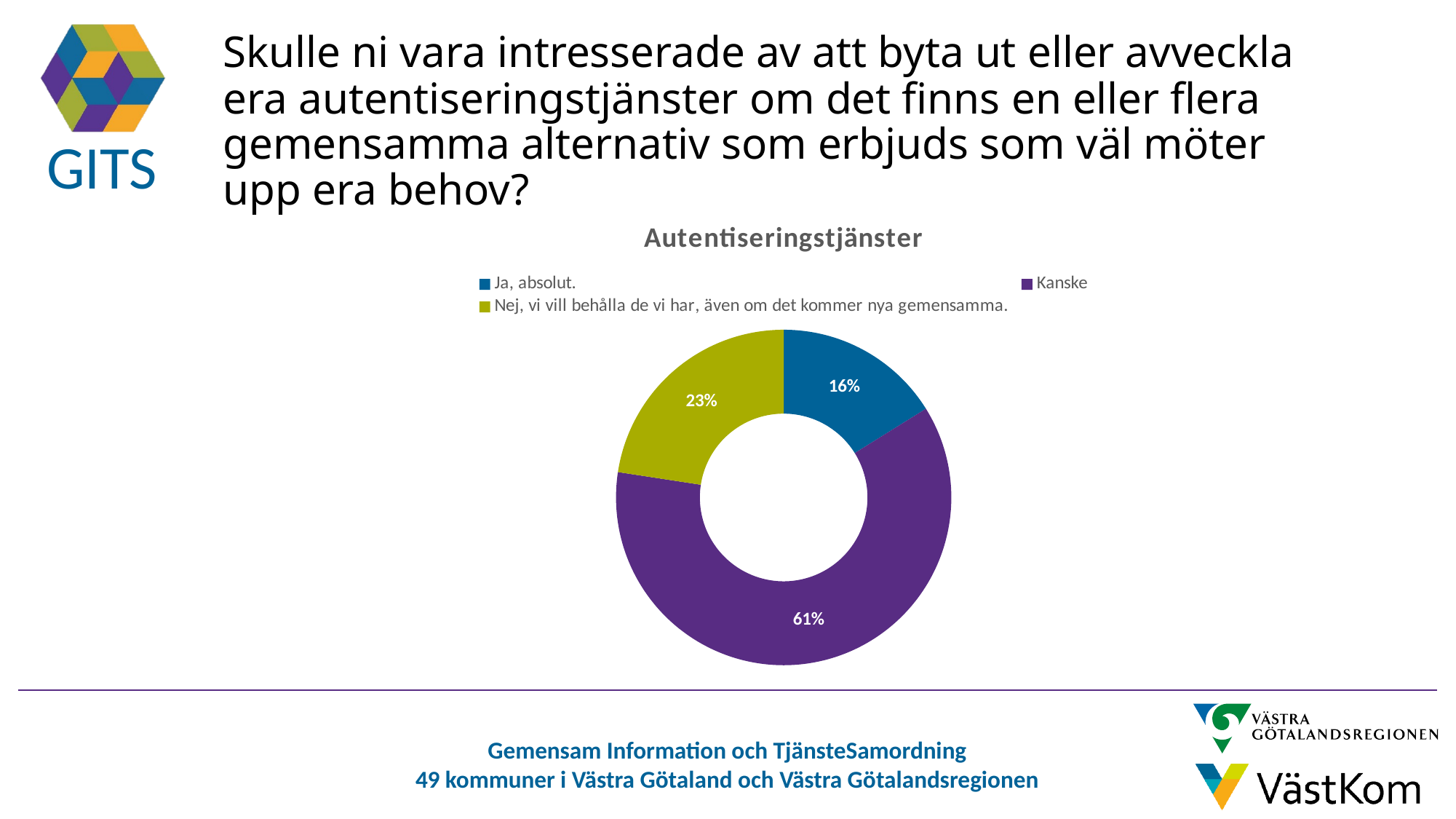
How many categories does the chart show? 3 Which is larger: the share for "Ja, absolut." or the share for "Nej, vi vill behålla de vi har, även om det kommer nya gemensamma."? Nej, vi vill behålla de vi har, även om det kommer nya gemensamma. What is the difference in percentage points between the "Nej, vi vill behålla de vi har, även om det kommer nya gemensamma." share and the "Ja, absolut." share? 7 What is the title of the chart? Autentiseringstjänster Which category has the largest share of the pie? Kanske What colour is the "Kanske" slice? Purple What share of the pie does "Kanske" represent? 61% What share of the pie does "Nej, vi vill behålla de vi har, även om det kommer nya gemensamma." represent? 23% What kind of chart is shown on the slide? Pie chart (doughnut) What share of the pie does "Ja, absolut." represent? 16% Which category has the smallest share of the pie? Ja, absolut. What is the difference in percentage points between the "Kanske" share and the "Ja, absolut." share? 45